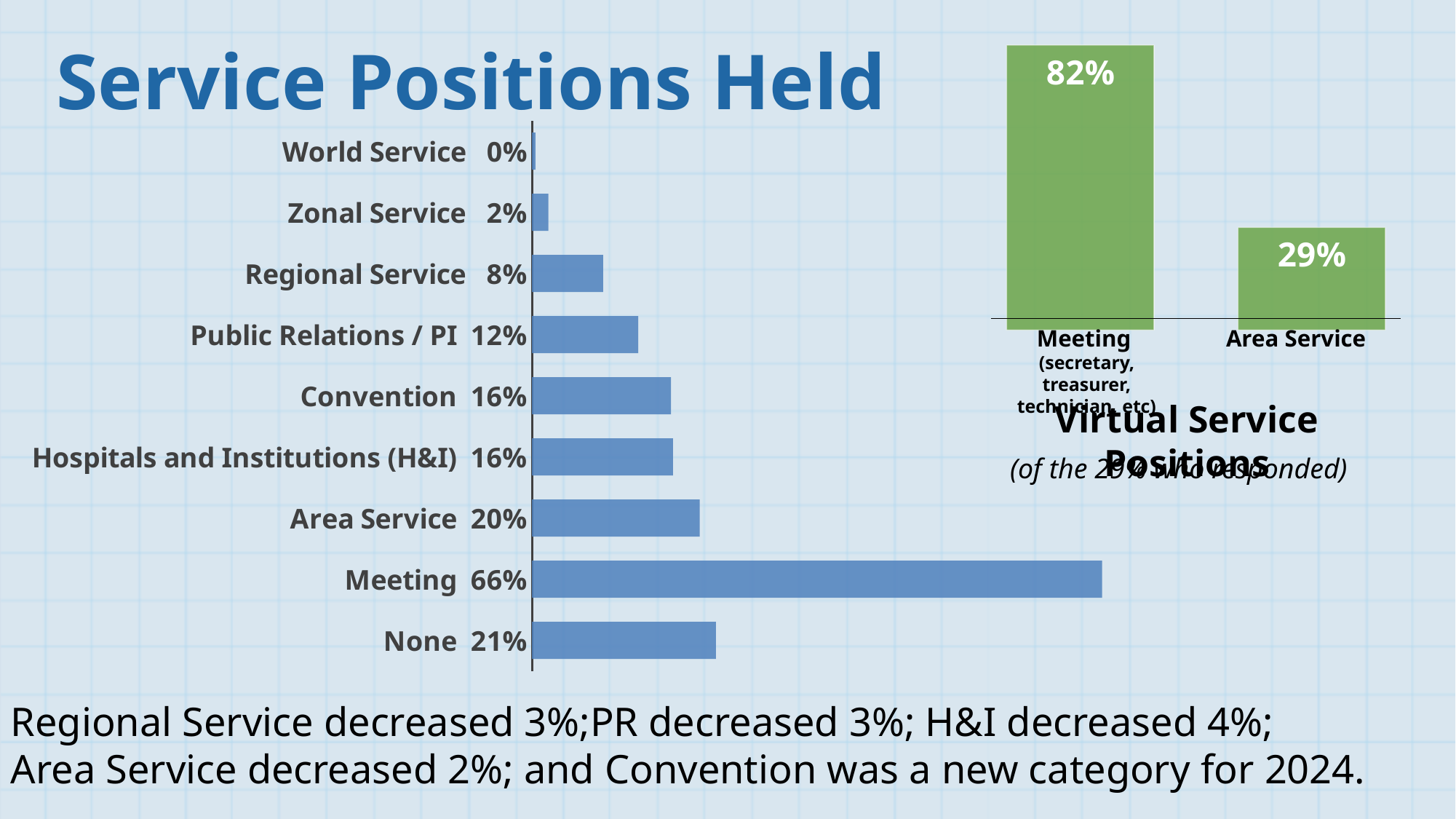
In the Service Positions Held chart, what is the value for Area Service? 20% In the Service Positions Held chart, which category has the lowest value? World Service How many categories are shown in the Service Positions Held chart? 9 In the Virtual Service Positions chart, what is the difference between the values for Meeting and Area Service? 53% In the Service Positions Held chart, what is the difference between the values for Meeting and None? 45% What kind of chart is the Service Positions Held chart? Bar chart In the Service Positions Held chart, what is the value for Meeting? 66% In the Service Positions Held chart, which category has the highest value? Meeting In the Service Positions Held chart, what is the value for Public Relations / PI? 12% In the Virtual Service Positions chart, what is the value for Area Service? 29% In the Service Positions Held chart, which is larger, the value for Regional Service or the value for Zonal Service? Regional Service How many categories are shown in the Virtual Service Positions chart? 2